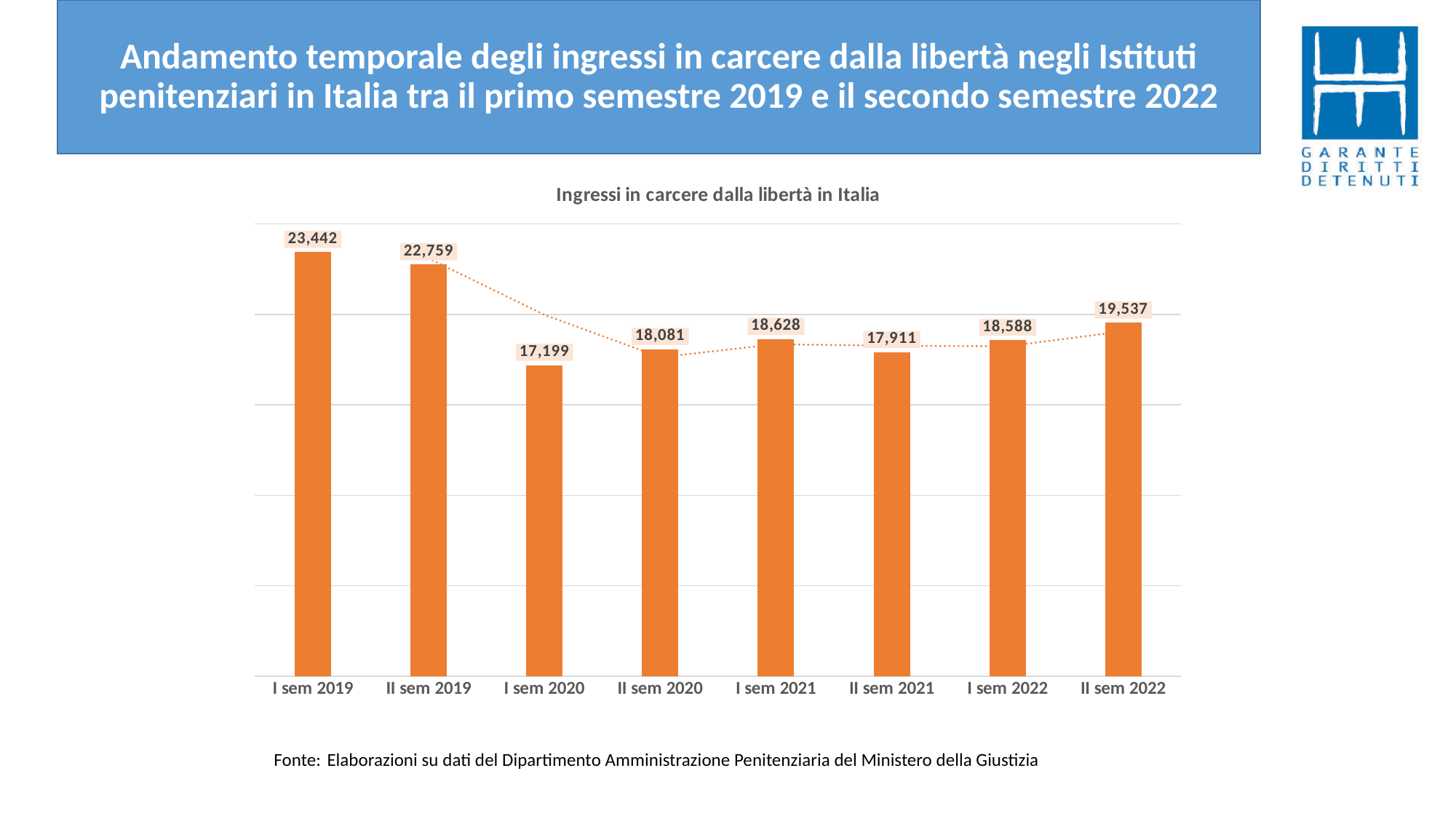
What is the difference between the values for II sem 2022 and I sem 2022? 949 What is the difference between the values for I sem 2019 and II sem 2019? 683 What is the value for I sem 2020? 17,199 What is the value for I sem 2019? 23,442 What kind of chart is shown on the slide? Bar chart What is the title of the chart? Ingressi in carcere dalla libertà in Italia Which semester has the lowest value? I sem 2020 What is the value for II sem 2021? 17,911 Which is larger, the value for I sem 2021 or the value for II sem 2021? I sem 2021 What is the value for II sem 2022? 19,537 How many semesters are shown on the x axis? 8 Which semester has the highest value? I sem 2019